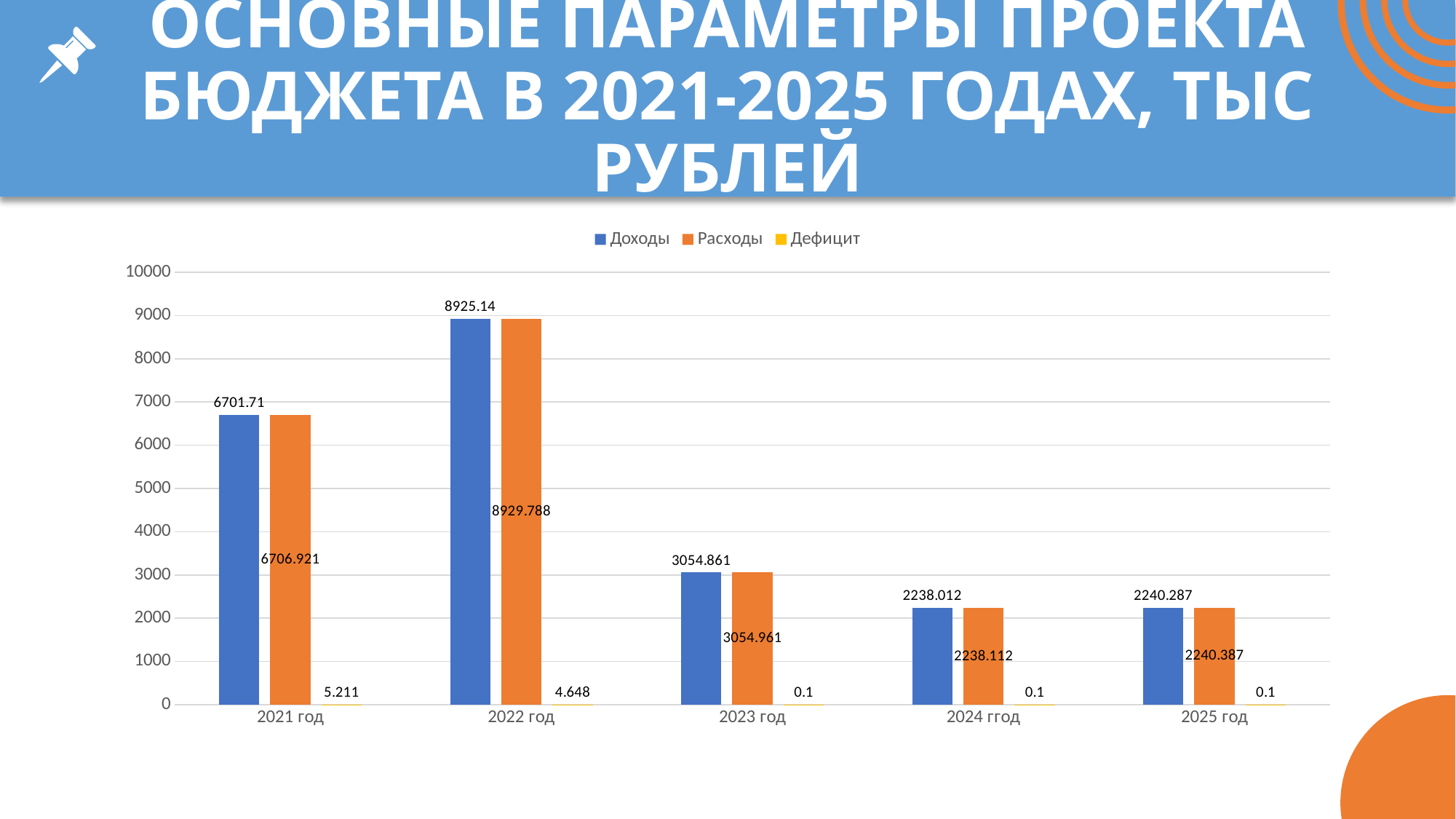
What is the value of Расходы for 2022 год? 8929.788 What is the difference between Доходы in 2022 год and Доходы in 2021 год? 2223.43 What is the value of Дефицит for 2021 год? 5.211 Is the value of Расходы for 2022 год greater or less than 8000? greater Which is larger: Доходы in 2023 год or Доходы in 2024 ггод? Доходы in 2023 год In which year is Доходы the highest? 2022 год How many series does the legend list? 3 How many years are shown on the x axis? 5 What is the value of Доходы for 2021 год? 6701.71 In which year is Дефицит the highest? 2021 год What kind of chart is shown on the slide? bar chart What is the value of Доходы for 2025 год? 2240.287